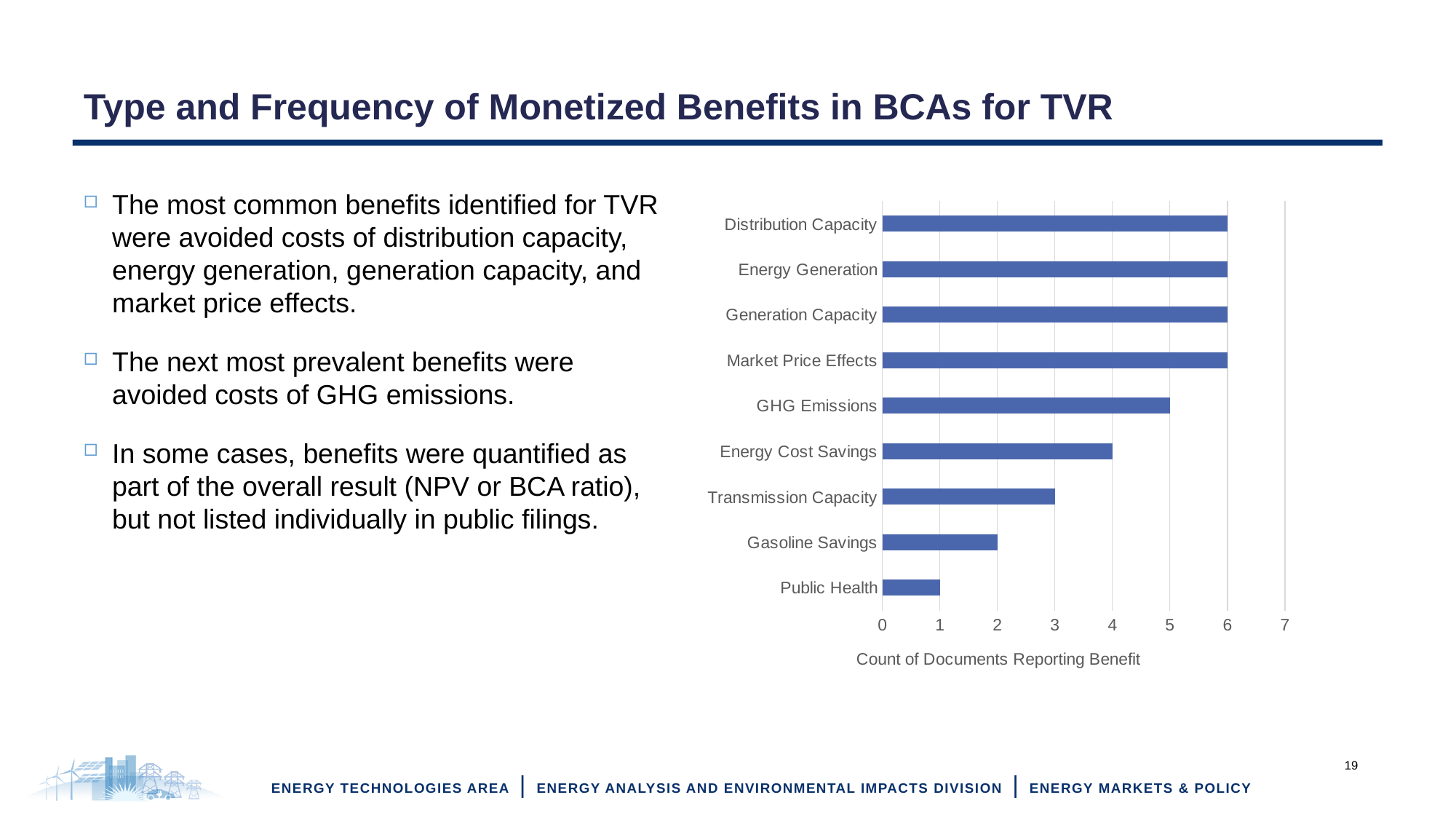
What is the count of documents reporting the Energy Cost Savings benefit? 4 What is the label on the horizontal axis of the chart? Count of Documents Reporting Benefit How many documents reported the GHG Emissions benefit? 5 Which has a higher count, Energy Cost Savings or Transmission Capacity? Energy Cost Savings How many benefit categories are shown in the chart? 9 What is the value for Market Price Effects? 6 Which benefit has the lowest count of documents reporting it? Public Health What type of chart is shown on the slide? bar chart What is the value for Public Health? 1 What is the difference between the counts for GHG Emissions and Gasoline Savings? 3 Is the value for Gasoline Savings greater or less than 3? less What is the value for Transmission Capacity? 3